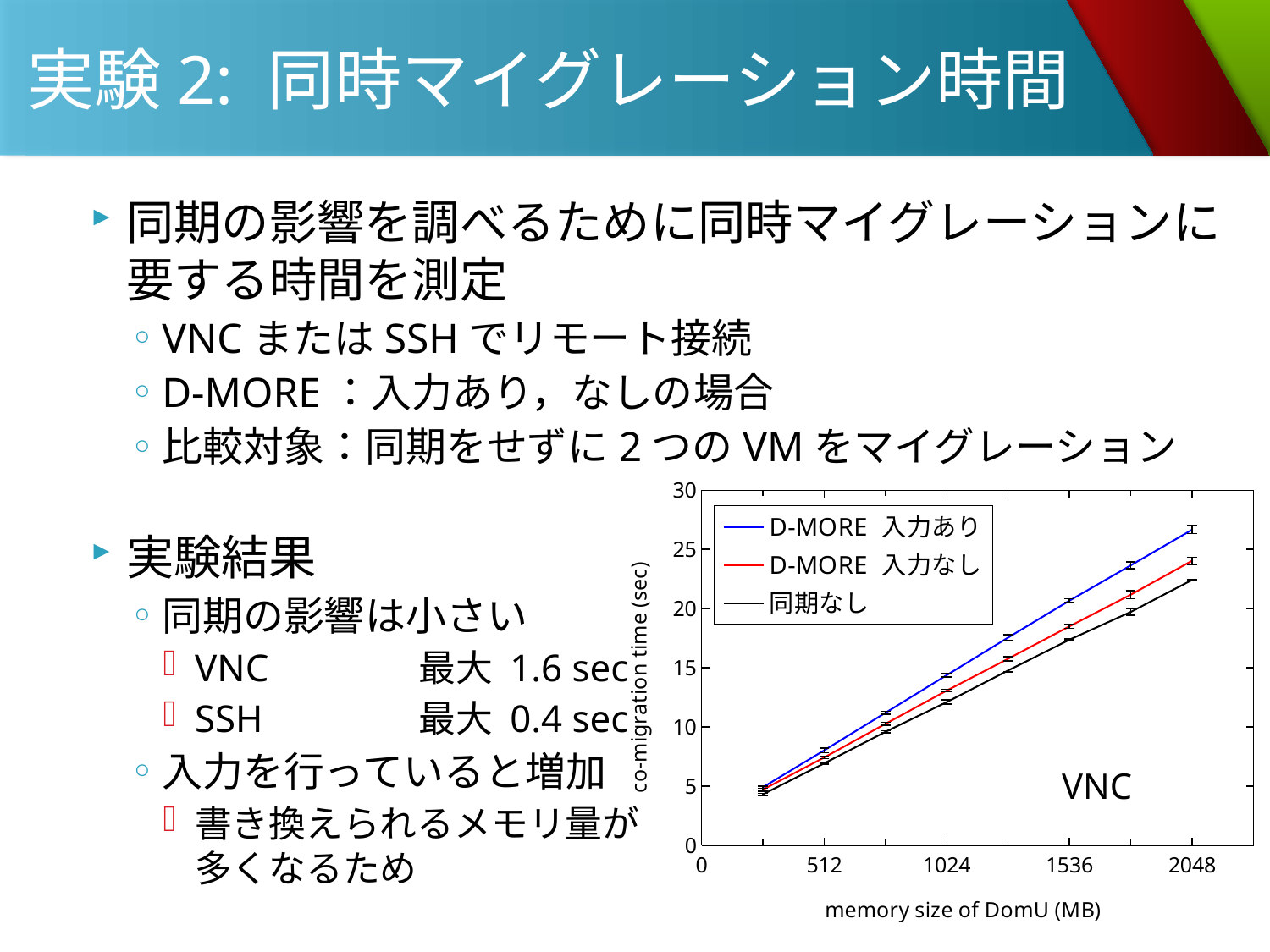
Which series has the highest co-migration time at a memory size of 2048 MB? D-MORE 入力あり Is the co-migration time for 同期なし at 2048 MB greater or less than 25 sec? less What is the label of the chart's x axis? memory size of DomU (MB) Is the co-migration time for D-MORE 入力なし at 1024 MB greater or less than 10 sec? greater Is the co-migration time for D-MORE 入力あり at 2048 MB greater or less than 25 sec? greater Which series has the lowest co-migration time at a memory size of 2048 MB? 同期なし Which series is shown in blue in the chart? D-MORE 入力あり How many labelled tick values are shown on the chart's x axis? 5 At a memory size of 1536 MB, which series has the larger co-migration time: D-MORE 入力あり or 同期なし? D-MORE 入力あり Does the co-migration time rise or fall as the memory size of DomU increases? rise What kind of chart is shown on the slide? line chart How many series does the chart's legend list? 3